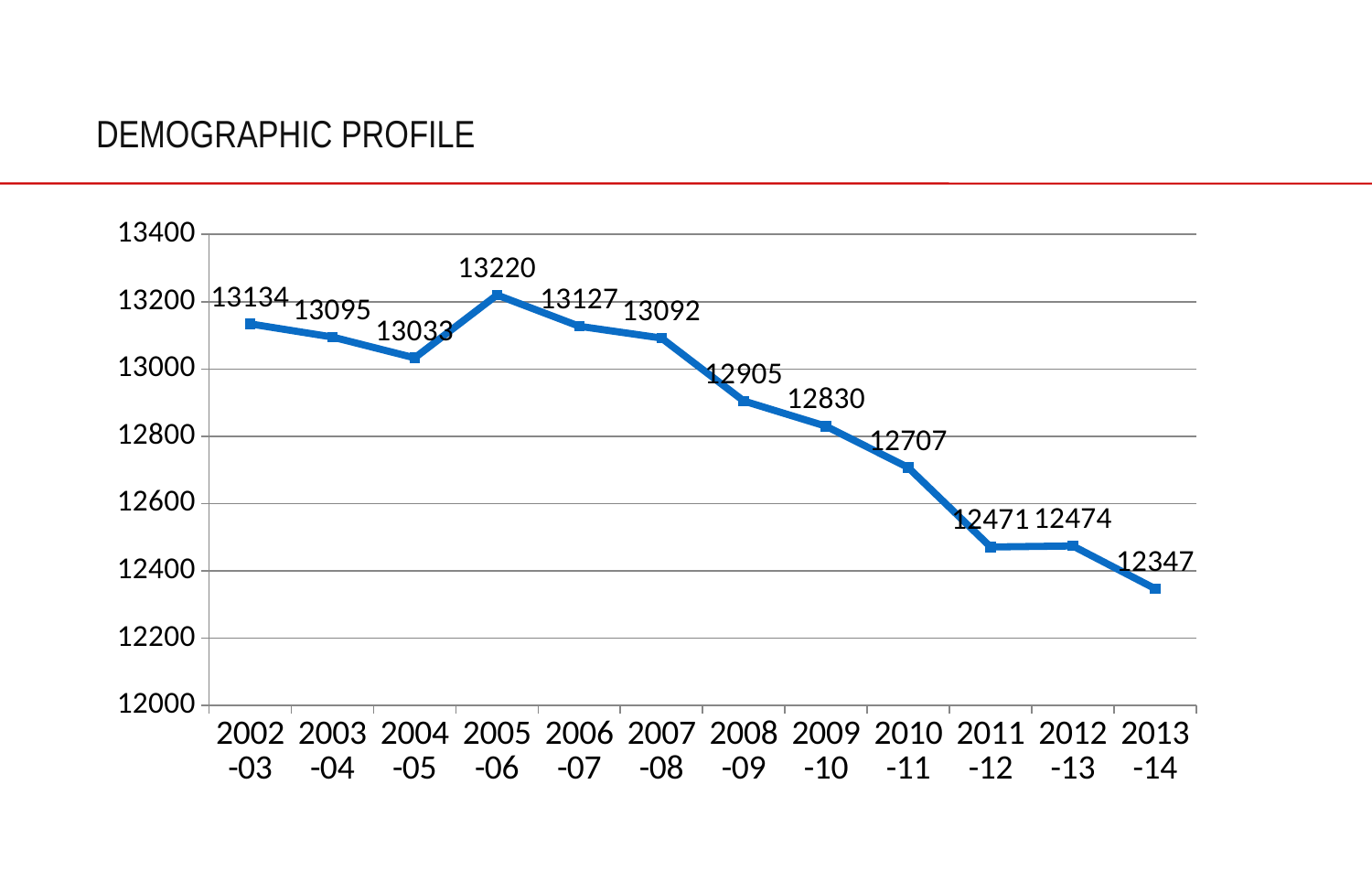
What is the value for 2005-06? 13220 What is the value for 2013-14? 12347 How many years are plotted on the chart? 12 Which is larger, the value for 2004-05 or the value for 2007-08? 2007-08 Is the value for 2010-11 greater or less than 12800? less What is the value for 2008-09? 12905 What is the difference between the values for 2002-03 and 2013-14? 787 Do the values generally rise or fall from 2005-06 to 2013-14? fall Which year has the lowest value? 2013-14 What is the difference between the values for 2005-06 and 2006-07? 93 Which year has the highest value? 2005-06 What kind of chart is shown on the slide? line chart